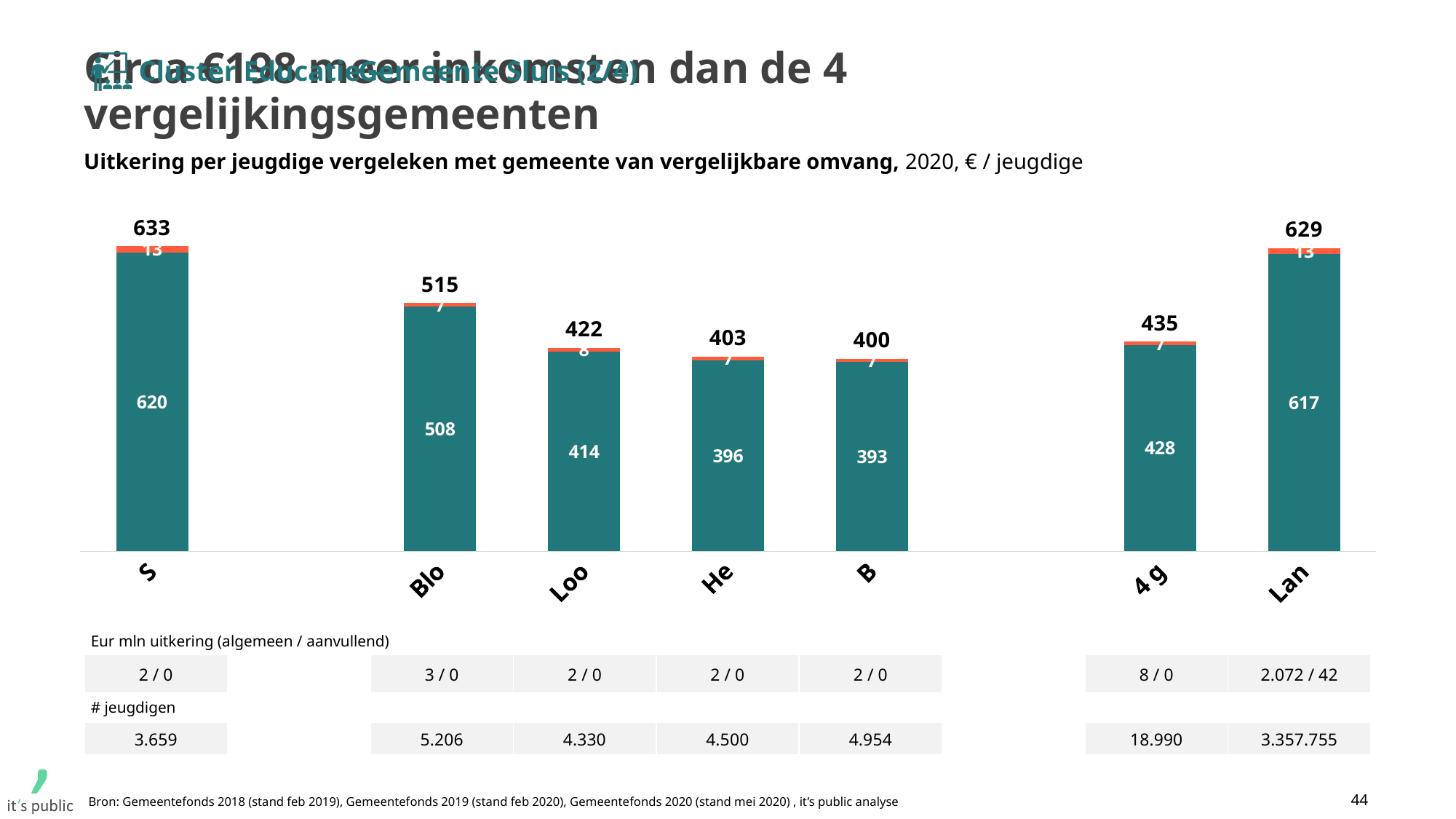
How many categories (bars) are shown in the chart? 7 What is the total value shown above the bar for S? 633 Which category has the highest total value? S What is the total value shown above the bar for 4 g? 435 What is the difference between the total for S and the total for Blo? 118 What is the difference between the teal segment of Lan and the teal segment of 4 g? 189 Which has a larger total value, Loo or He? Loo What is the value of the large teal segment of the bar for Lan? 617 What unit is stated in the chart subtitle for the values? € / jeugdige Which category has the lowest total value? B What kind of chart is shown on the slide? Stacked bar chart What is the value of the teal segment of the bar for Loo? 414